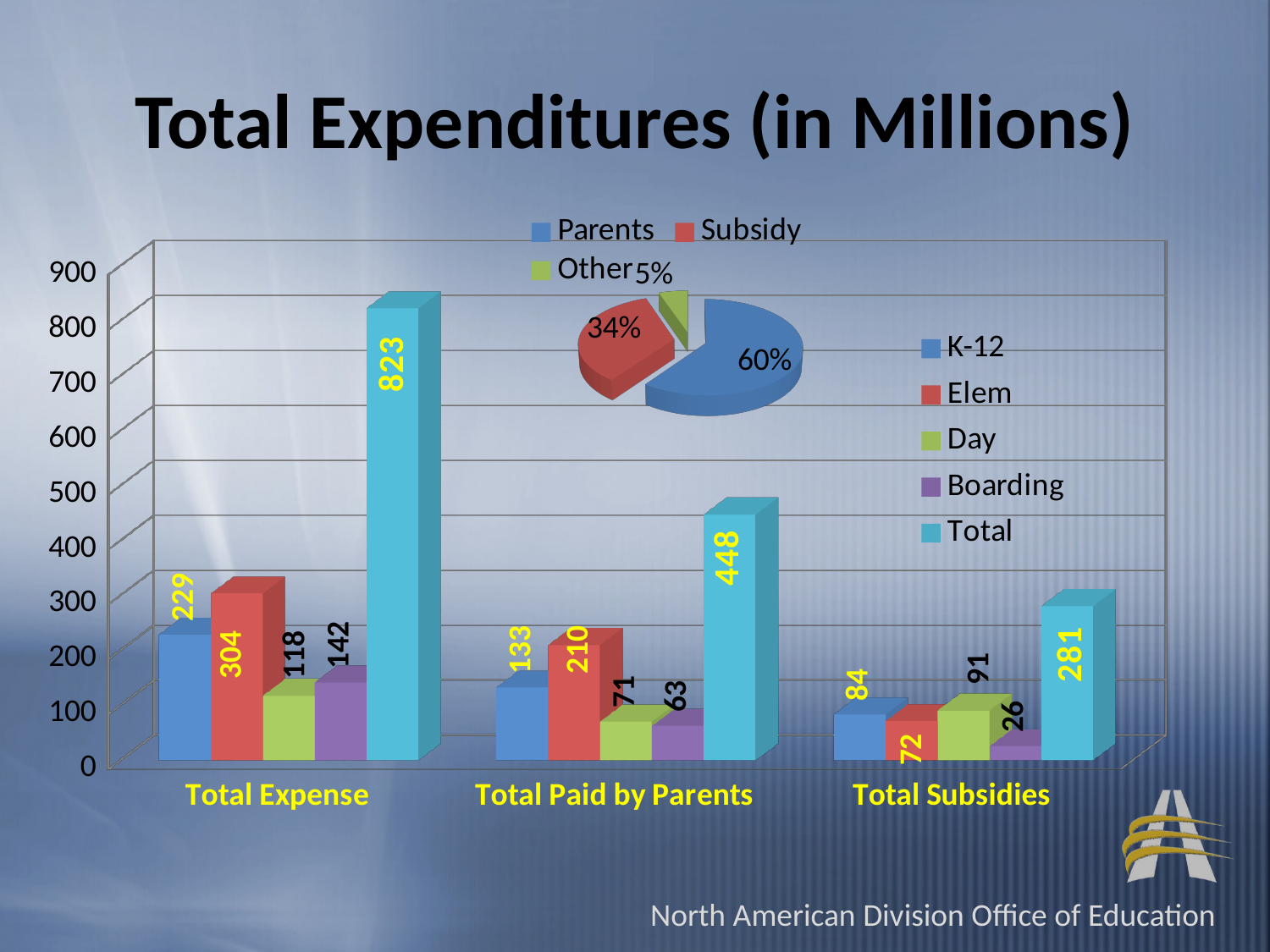
How many categories are shown on the x axis of the bar chart? 3 In the bar chart, which series has the lowest value for Total Paid by Parents? Boarding In the bar chart, what is the Elem value for Total Paid by Parents? 210 How many series does the bar chart's legend list? 5 In the bar chart, what is the K-12 value for Total Subsidies? 84 In the bar chart, which is larger for Total Subsidies: Day or Elem? Day In the pie chart, what share does Parents have? 60% In the pie chart, which slice is the smallest? Other In the bar chart, what is the Boarding value for Total Subsidies? 26 In the bar chart, which series has the highest value for Total Expense? Total In the bar chart, what is the difference between the Total values for Total Expense and Total Paid by Parents? 375 In the bar chart, what is the Total value for Total Expense? 823